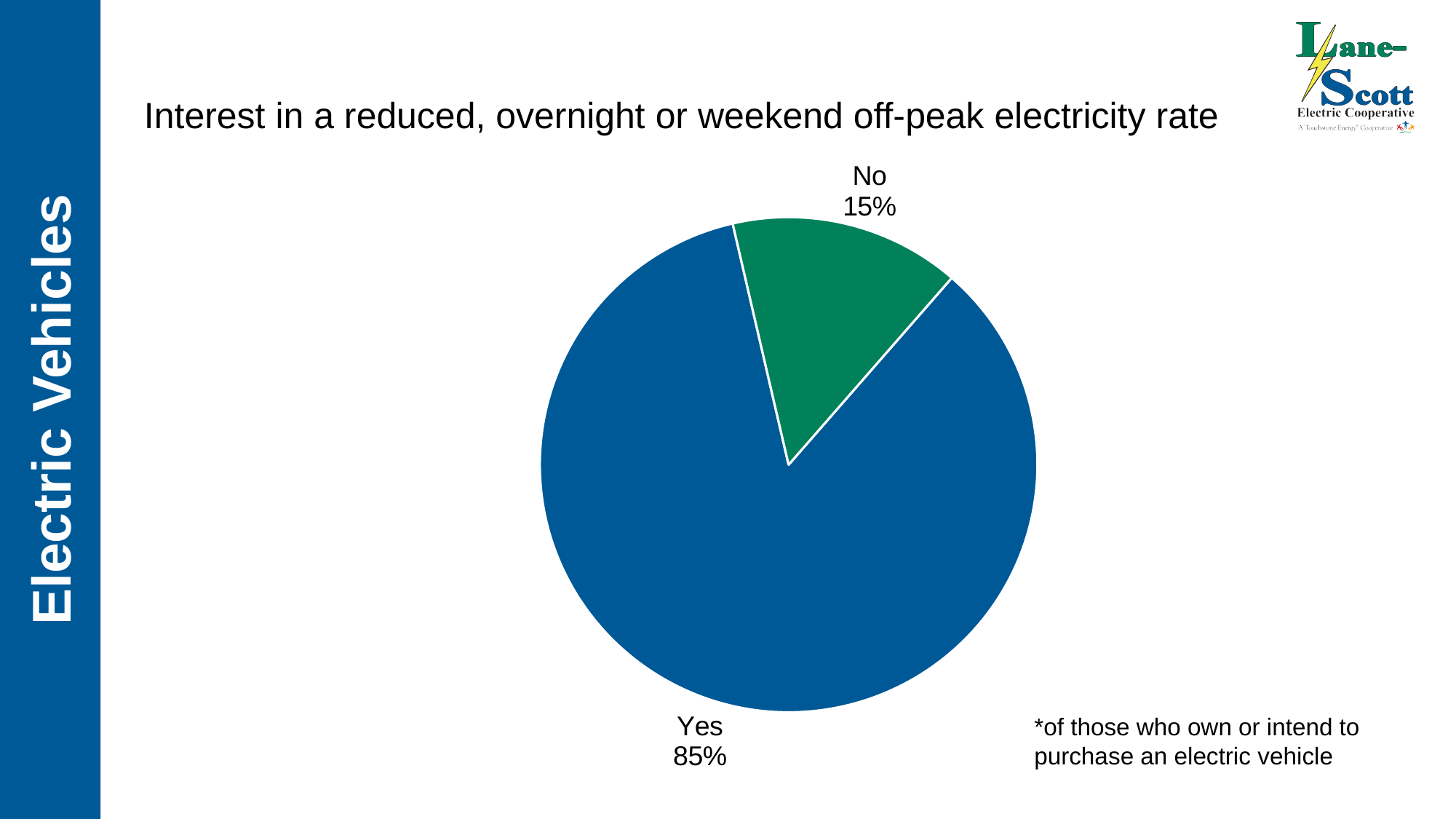
What kind of chart is shown on the slide? pie chart Which response has the smallest share of the pie? No Which response has the largest share of the pie? Yes How many slices does the pie chart have? 2 What share of the pie does the No slice represent? 15% What colour is the Yes slice? blue What is the difference in percentage points between the Yes and No slices? 70 What percentage of respondents answered No? 15% What percentage of respondents answered Yes? 85% Which slice is larger, Yes or No? Yes What is the title of the chart? Interest in a reduced, overnight or weekend off-peak electricity rate